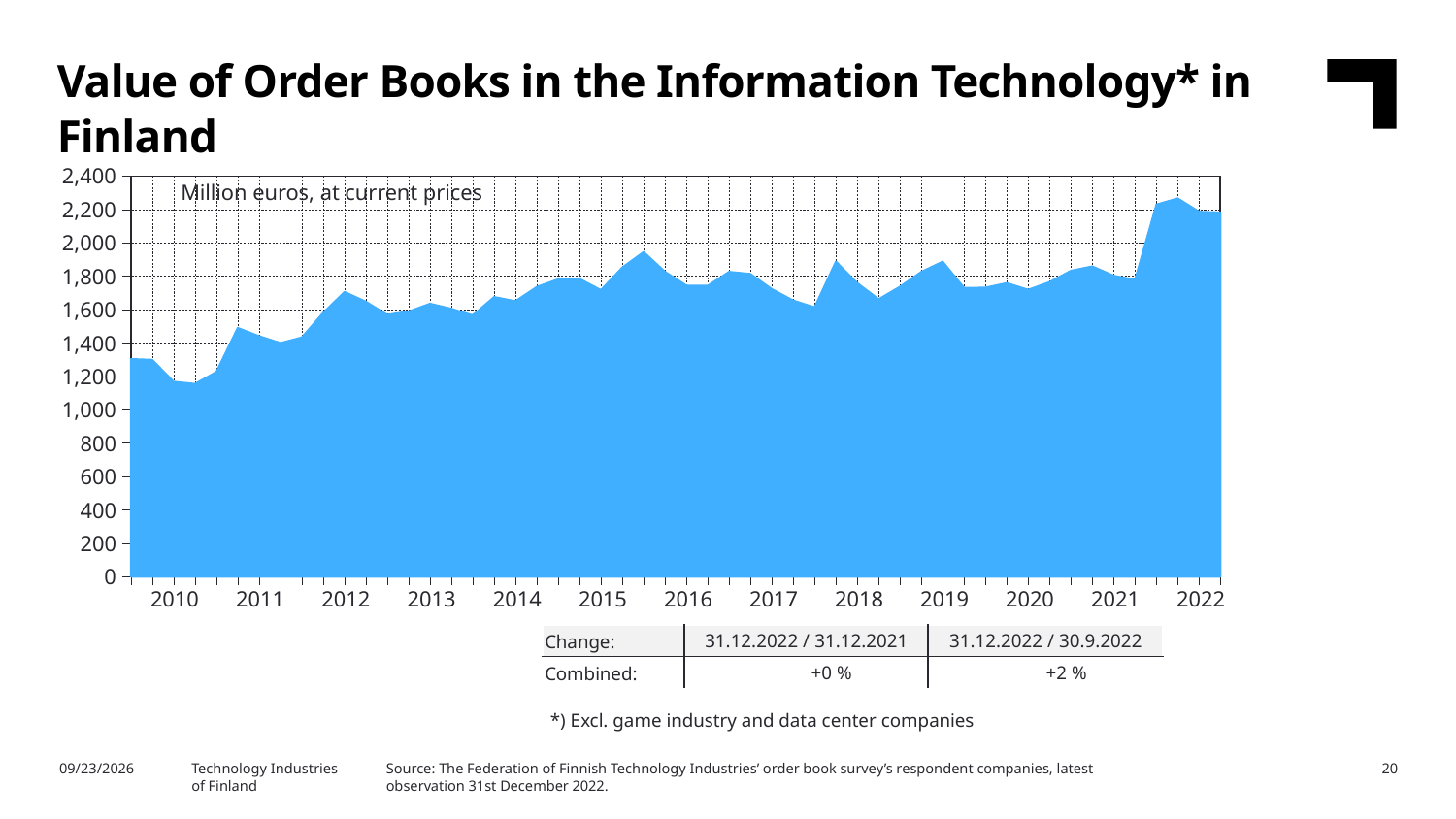
How many year labels are shown on the x axis of the chart? 13 Is the highest value reached in the chart greater or less than 2,200? greater Is the value of order books at the start of 2016 greater or less than 2,000? less What kind of chart is shown on the slide? Area chart Which year shows the lowest values of order books in the chart? 2010 Overall, do the values of order books rise or fall from 2010 to 2022? rise Is the value of order books at the start of 2010 greater or less than 1,200? greater Is the value of order books at the end of 2022 larger or smaller than at the start of 2010? larger In what unit are the values on the chart expressed, according to the label inside the plot area? Million euros, at current prices What is the title of the chart on the slide? Value of Order Books in the Information Technology* in Finland